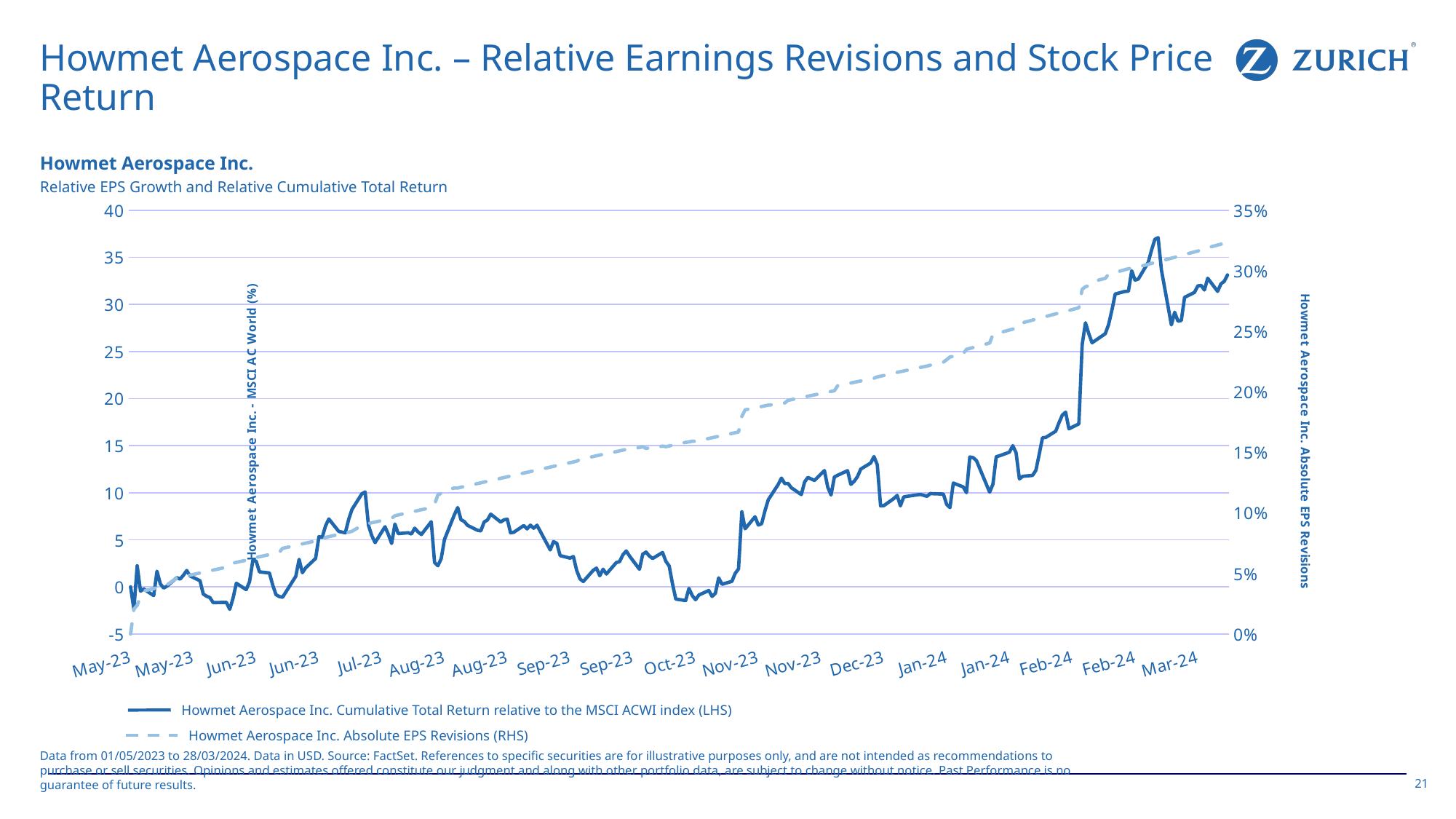
Is the Cumulative Total Return relative to the MSCI ACWI index at Jul-23 greater or less than 15? less Which series is drawn with a dashed line according to the legend? Howmet Aerospace Inc. Absolute EPS Revisions (RHS) Is the Absolute EPS Revisions value at Oct-23 greater or less than 20%? less What type of chart is shown on the slide? line chart What is the highest value shown on the right-hand axis? 35% Is the Absolute EPS Revisions value at Jun-23 greater or less than 15%? less Overall, does the Howmet Aerospace Inc. Cumulative Total Return relative to the MSCI ACWI index (LHS) line rise or fall from May-23 to Mar-24? rise How many series does the legend list? 2 Does the Howmet Aerospace Inc. Absolute EPS Revisions (RHS) line rise or fall from May-23 to Mar-24? rise